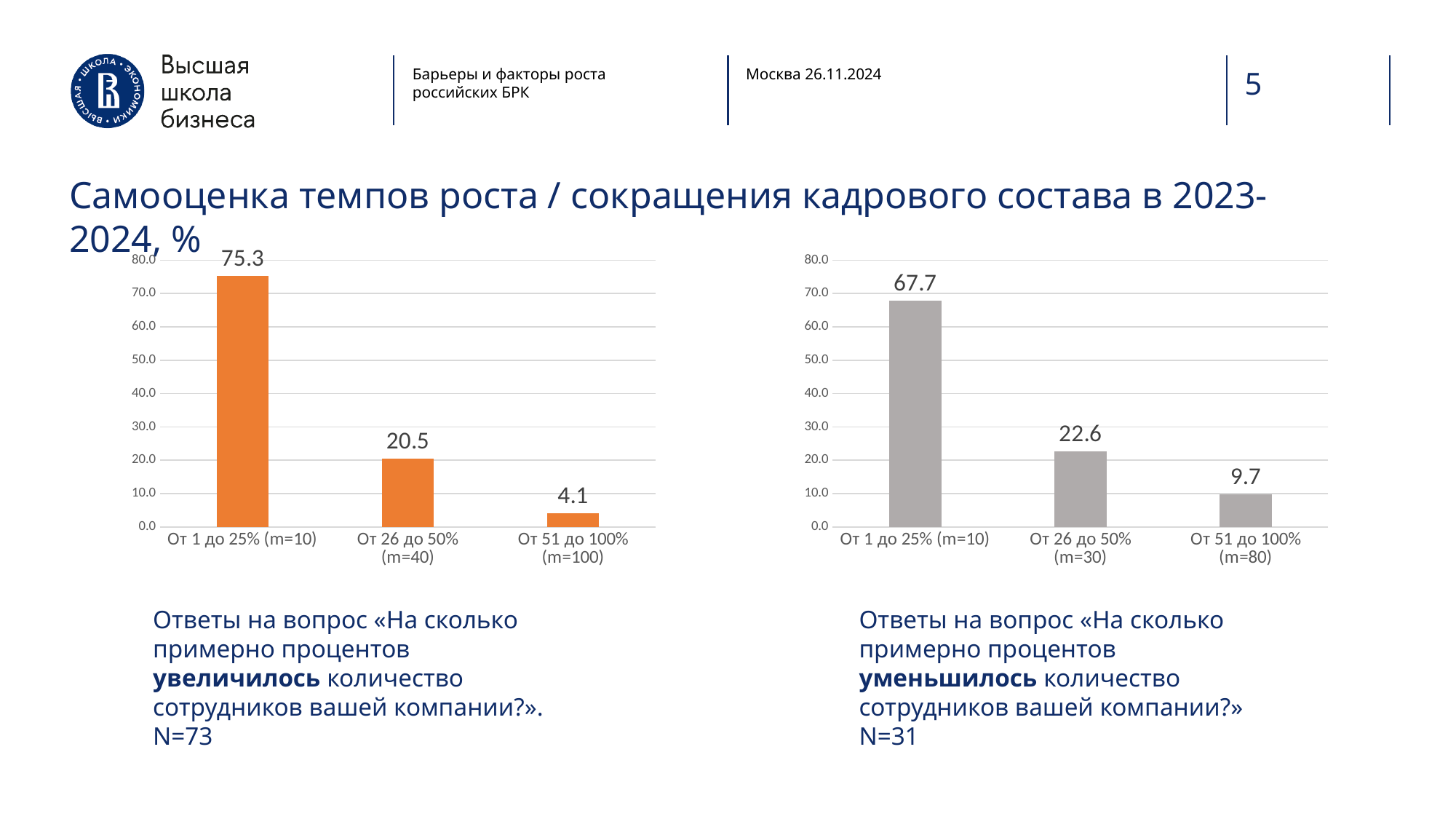
In the right chart (decrease in staff), what is the difference between the values for 'От 26 до 50% (m=30)' and 'От 51 до 100% (m=80)'? 12.9 In the left chart (increase in staff), what is the difference between the values for 'От 1 до 25% (m=10)' and 'От 26 до 50% (m=40)'? 54.8 In the right chart (decrease in staff), is the value for 'От 1 до 25% (m=10)' greater or less than 60.0? greater In the right chart (decrease in staff), which category has the highest value? От 1 до 25% (m=10) In the right chart (decrease in staff), what is the value for 'От 26 до 50% (m=30)'? 22.6 How many categories are shown in the left chart (increase in staff)? 3 What colour are the bars in the left chart (increase in staff)? Orange In the left chart (increase in staff), what is the value for 'От 1 до 25% (m=10)'? 75.3 Which is larger: the value for 'От 51 до 100%' in the left chart or in the right chart? Right chart (9.7) In the left chart (increase in staff), do the values rise or fall from left to right along the x axis? Fall What kind of chart is the right chart (decrease in staff)? Bar chart In the left chart (increase in staff), which category has the lowest value? От 51 до 100% (m=100)